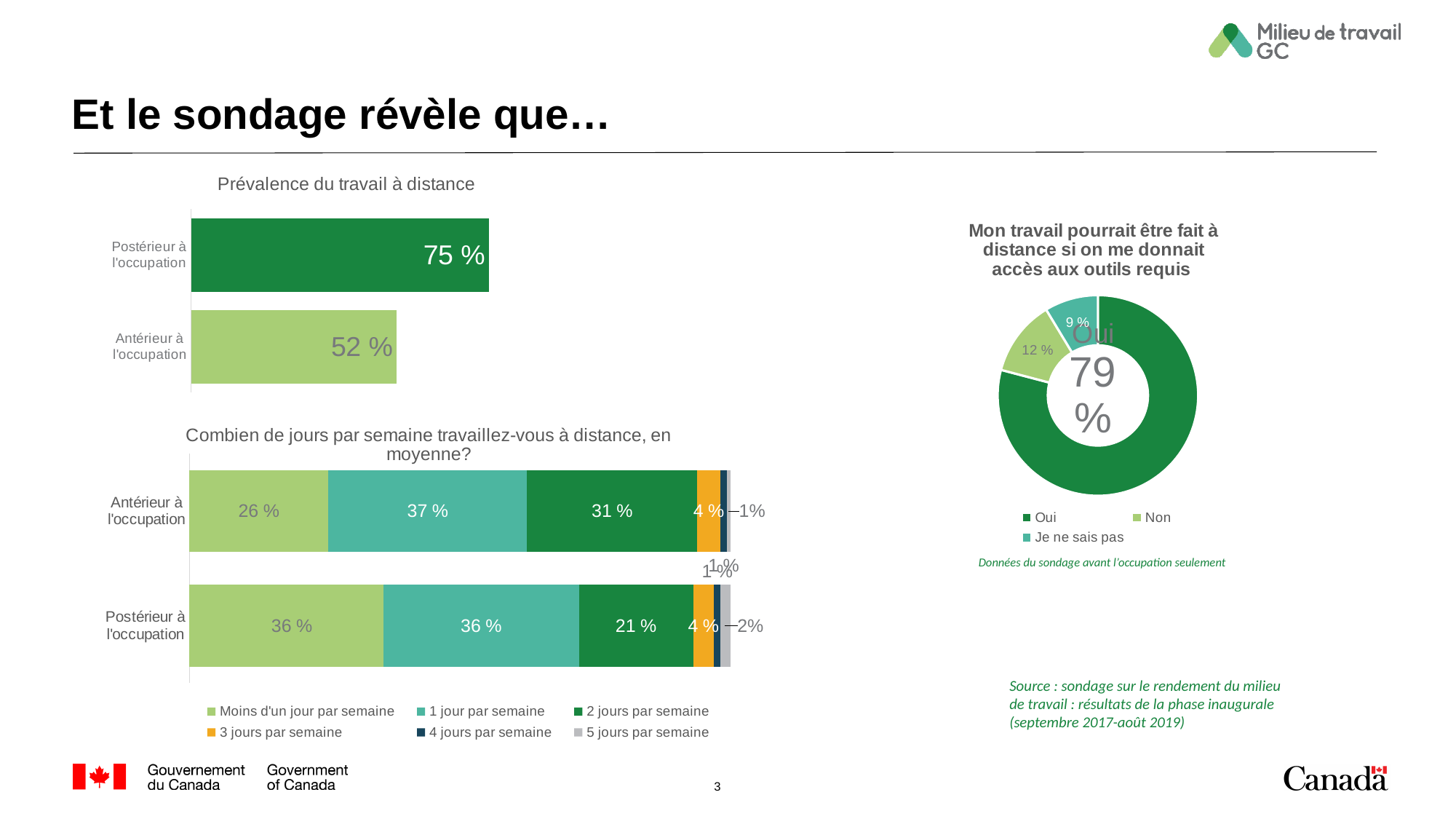
In the 'Prévalence du travail à distance' chart, what is the value for 'Postérieur à l'occupation'? 75 % In the 'Combien de jours par semaine travaillez-vous à distance, en moyenne?' chart, which is larger for 'Antérieur à l'occupation': 'Moins d'un jour par semaine' or '2 jours par semaine'? 2 jours par semaine In the 'Combien de jours par semaine travaillez-vous à distance, en moyenne?' chart, how many series does the legend list? 6 In the 'Combien de jours par semaine travaillez-vous à distance, en moyenne?' chart, what is the value for '1 jour par semaine' for 'Antérieur à l'occupation'? 37 % In the 'Combien de jours par semaine travaillez-vous à distance, en moyenne?' chart, what is the difference between the '2 jours par semaine' values for 'Antérieur à l'occupation' and 'Postérieur à l'occupation'? 10 % In the 'Combien de jours par semaine travaillez-vous à distance, en moyenne?' chart, what is the value for '2 jours par semaine' for 'Postérieur à l'occupation'? 21 % In the donut chart 'Mon travail pourrait être fait à distance si on me donnait accès aux outils requis', what share is 'Je ne sais pas'? 9 % In the donut chart 'Mon travail pourrait être fait à distance si on me donnait accès aux outils requis', what share is 'Oui'? 79 % In the 'Prévalence du travail à distance' chart, what is the difference between the 'Postérieur à l'occupation' and 'Antérieur à l'occupation' values? 23 % What kind of chart is 'Prévalence du travail à distance'? Bar chart In the 'Prévalence du travail à distance' chart, what is the value for 'Antérieur à l'occupation'? 52 % In the donut chart 'Mon travail pourrait être fait à distance si on me donnait accès aux outils requis', which category has the smallest share? Je ne sais pas